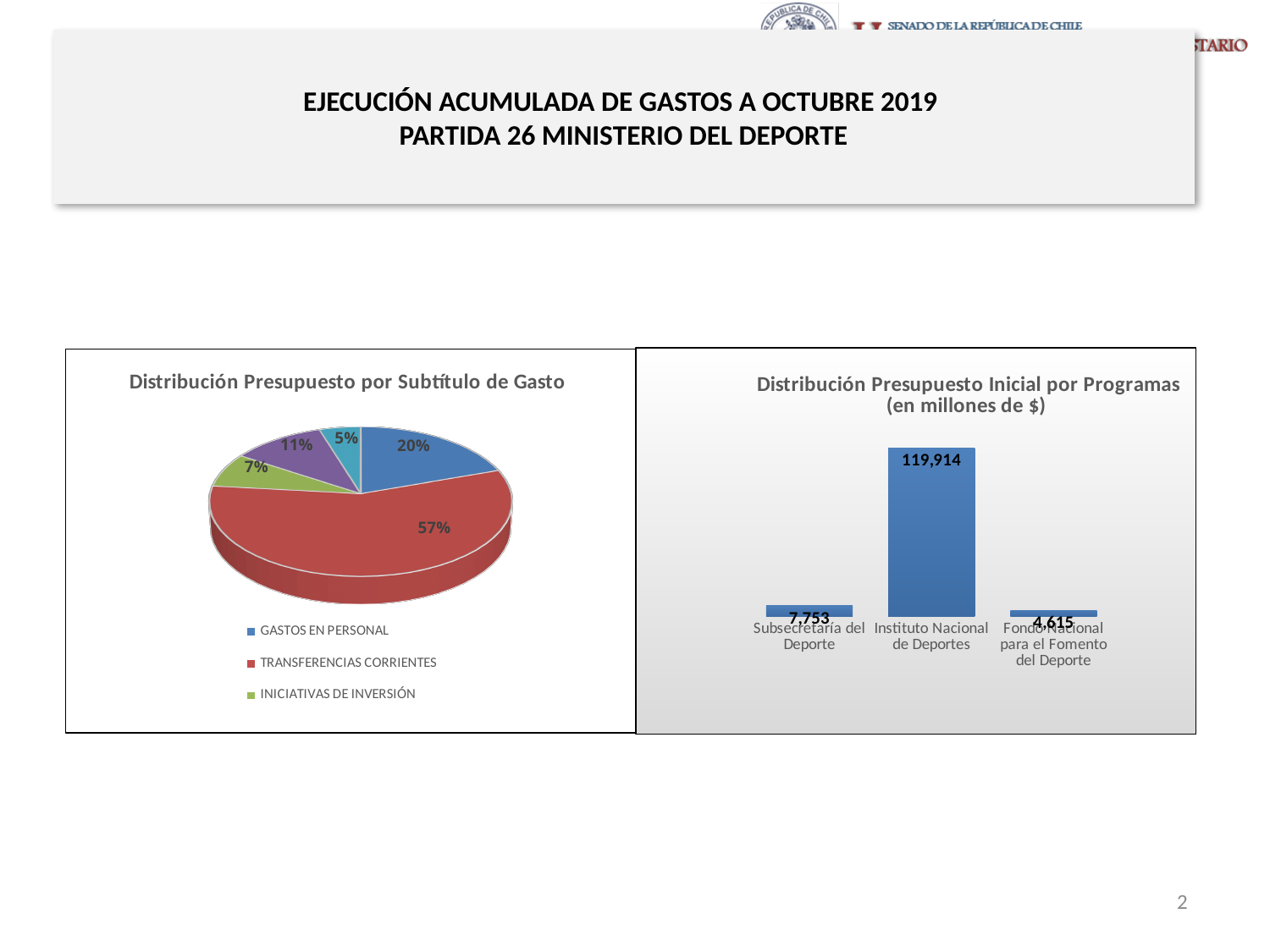
In the chart 'Distribución Presupuesto por Subtítulo de Gasto', what share of the pie is TRANSFERENCIAS CORRIENTES? 57% In the chart 'Distribución Presupuesto Inicial por Programas', what is the value for Instituto Nacional de Deportes? 119,914 In the chart 'Distribución Presupuesto por Subtítulo de Gasto', what share of the pie is GASTOS EN PERSONAL? 20% In the chart 'Distribución Presupuesto Inicial por Programas', what is the difference between Instituto Nacional de Deportes and Subsecretaría del Deporte? 112,161 In the chart 'Distribución Presupuesto Inicial por Programas', what is the value for Fondo Nacional para el Fomento del Deporte? 4,615 What kind of chart is 'Distribución Presupuesto por Subtítulo de Gasto'? Pie chart In the chart 'Distribución Presupuesto Inicial por Programas', which program has the lowest value? Fondo Nacional para el Fomento del Deporte In the chart 'Distribución Presupuesto por Subtítulo de Gasto', what share of the pie is INICIATIVAS DE INVERSIÓN? 7% In the chart 'Distribución Presupuesto por Subtítulo de Gasto', how many slices does the pie have? 5 In the chart 'Distribución Presupuesto Inicial por Programas', what is the value for Subsecretaría del Deporte? 7,753 In the chart 'Distribución Presupuesto por Subtítulo de Gasto', which category has the largest slice? TRANSFERENCIAS CORRIENTES What kind of chart is 'Distribución Presupuesto Inicial por Programas'? Bar chart